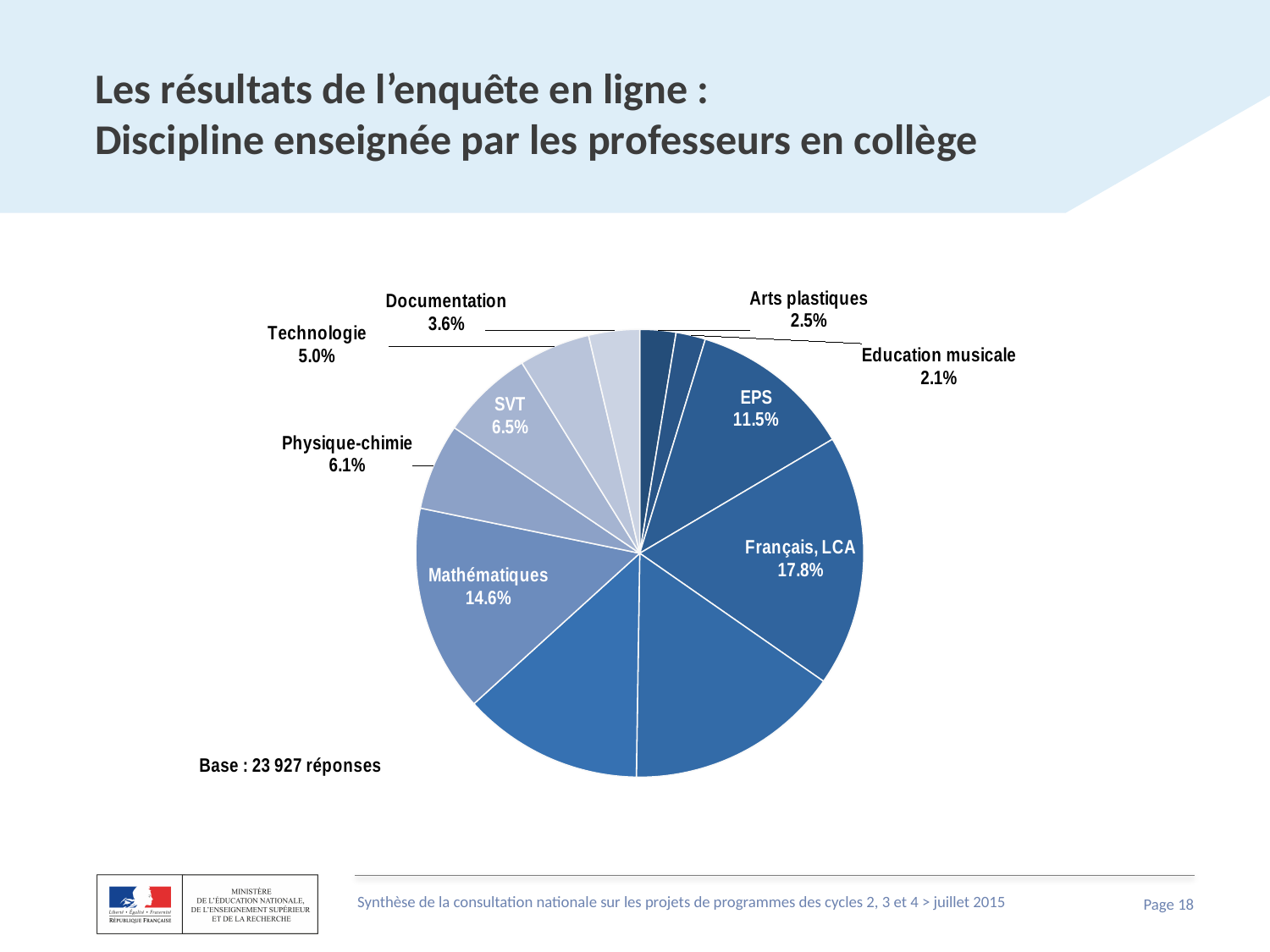
What share of the pie does Français, LCA represent? 17.8% How many responses form the base of the chart, as stated on the slide? 23 927 réponses Which is larger, the share for Arts plastiques or the share for Education musicale? Arts plastiques What is the value shown for EPS? 11.5% What is the difference between the shares for Français, LCA and Mathématiques? 3.2% What percentage is shown for Education musicale? 2.1% What is the value shown for Technologie? 5.0% What percentage is shown for Physique-chimie? 6.1% What percentage is shown for SVT? 6.5% What type of chart is shown on the slide? pie chart What is the value shown for Mathématiques? 14.6% What is the value shown for Documentation? 3.6%